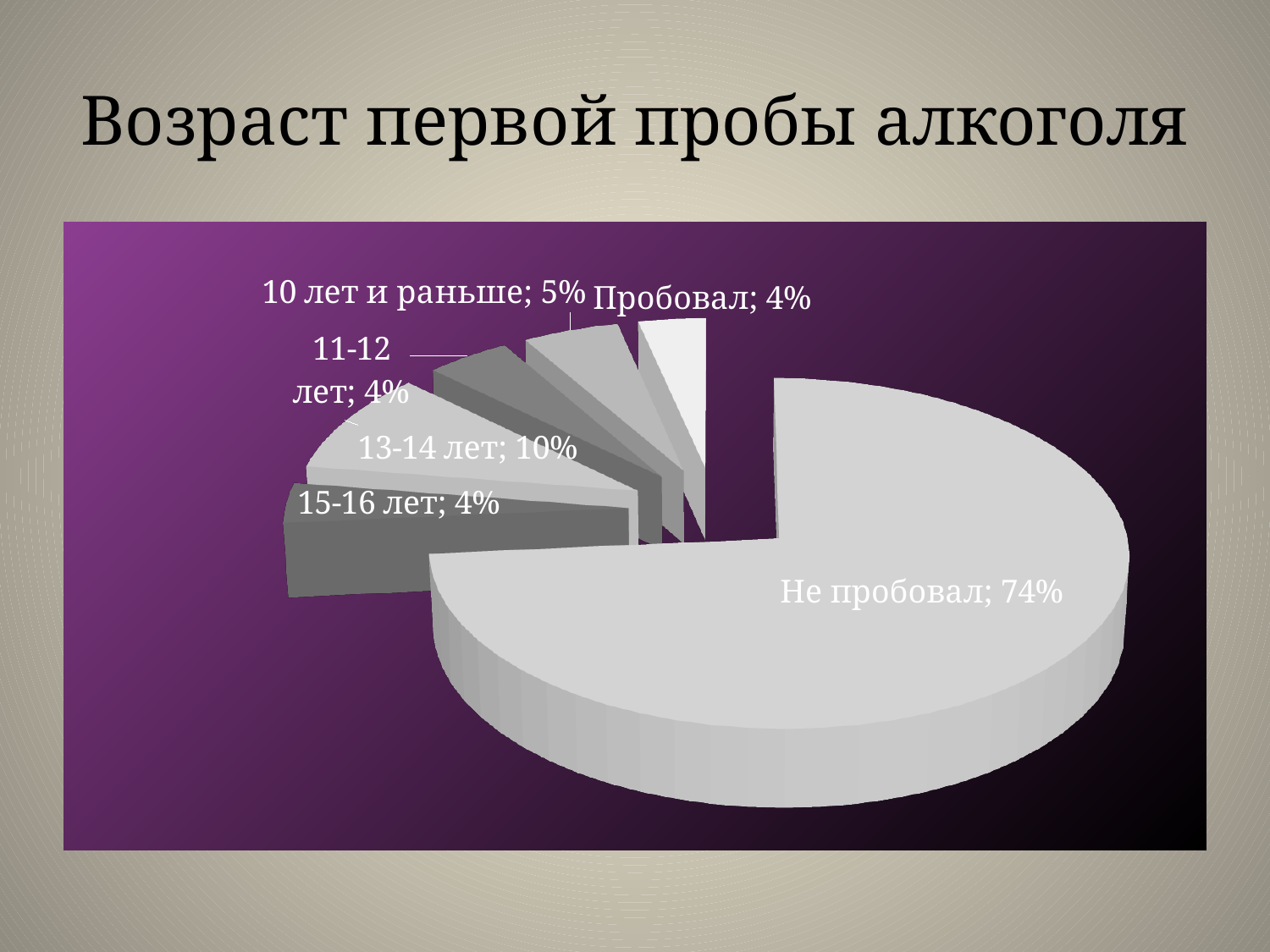
How many slices does the pie chart have? 6 What is the difference between the values for "10 лет и раньше" and "11-12 лет"? 1% What kind of chart is shown on the slide? Pie chart Which is larger, the value for "13-14 лет" or the value for "10 лет и раньше"? 13-14 лет What is the value shown for "Пробовал"? 4% What is the title of the chart on the slide? Возраст первой пробы алкоголя What is the value shown for "15-16 лет"? 4% What is the value shown for "13-14 лет"? 10% What is the difference between the values for "Не пробовал" and "13-14 лет"? 64% What is the value shown for "10 лет и раньше"? 5% What share of the pie is labelled "Не пробовал"? 74% Which slice of the pie is the largest? Не пробовал